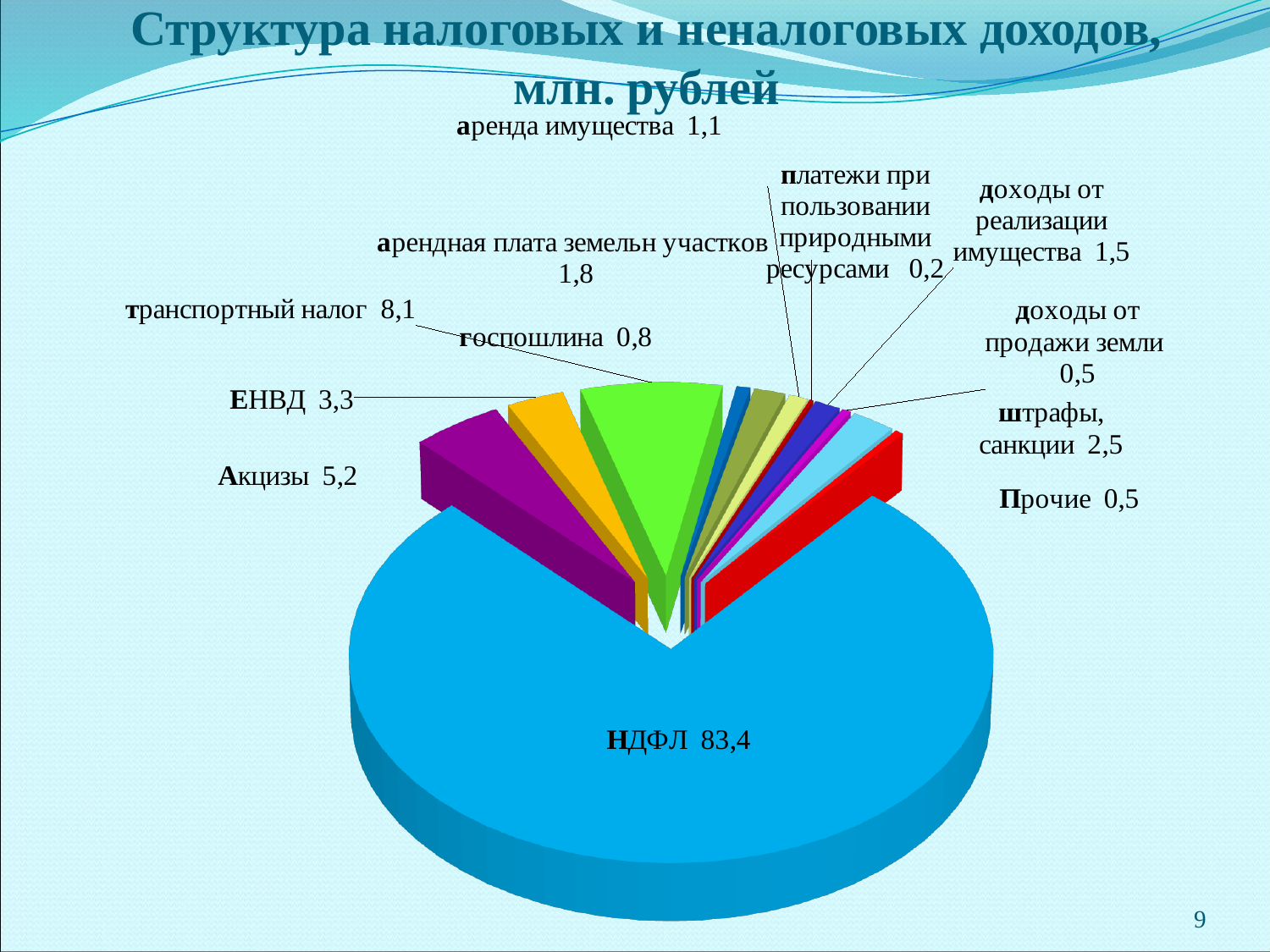
What is the value for транспортный налог? 8,1 Which category has the largest slice of the pie? НДФЛ What is the title of the chart? Структура налоговых и неналоговых доходов, млн. рублей How many categories (slices) does the pie chart have? 12 What is the difference between the values for Акцизы and ЕНВД? 1,9 What is the value for арендная плата земельн участков? 1,8 Which category has the smallest value? платежи при пользовании природными ресурсами Which is larger, the value for Акцизы or the value for ЕНВД? Акцизы What is the value for НДФЛ? 83,4 What is the difference between the values for НДФЛ and транспортный налог? 75,3 What is the value for штрафы, санкции? 2,5 What kind of chart is shown on the slide? Pie chart